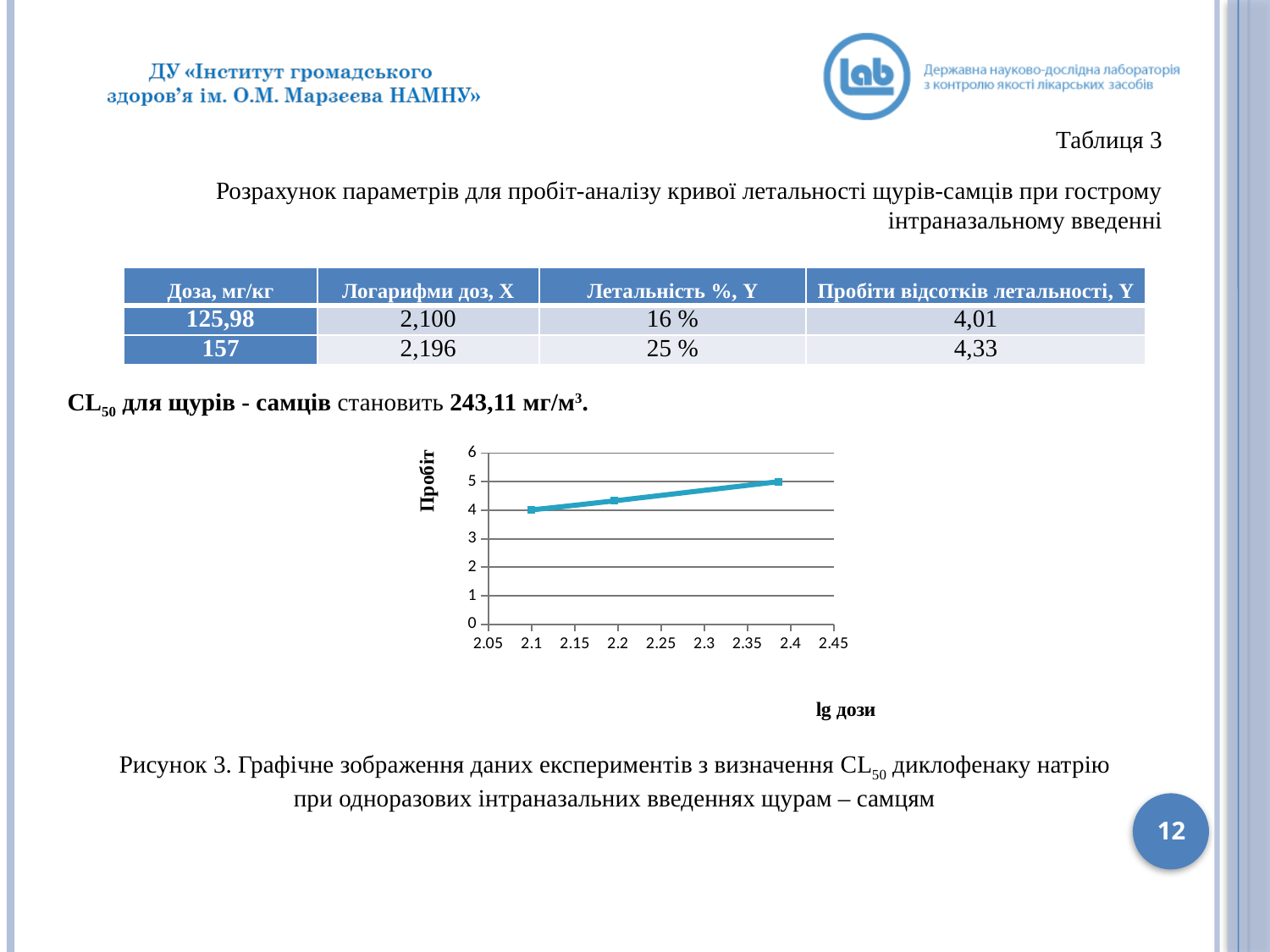
What is the label of the x axis of the chart? lg дози Do the plotted values rise or fall as lg дози increases along the x axis? rise How many data points are plotted on the chart? 3 What is the label of the y axis of the chart? Пробіт What kind of chart is shown on the slide? line chart Which plotted point has the lowest value: the leftmost, the middle, or the rightmost? the leftmost Is the value for the rightmost point on the chart greater or less than 4? greater Is the value for the point at lg дози 2.1 larger or smaller than the value for the point near lg дози 2.2? smaller Which plotted point has the highest value: the leftmost, the middle, or the rightmost? the rightmost Is the value for the point at lg дози 2.1 greater or less than 5? less Is the value for the point at lg дози 2.1 greater or less than 3? greater